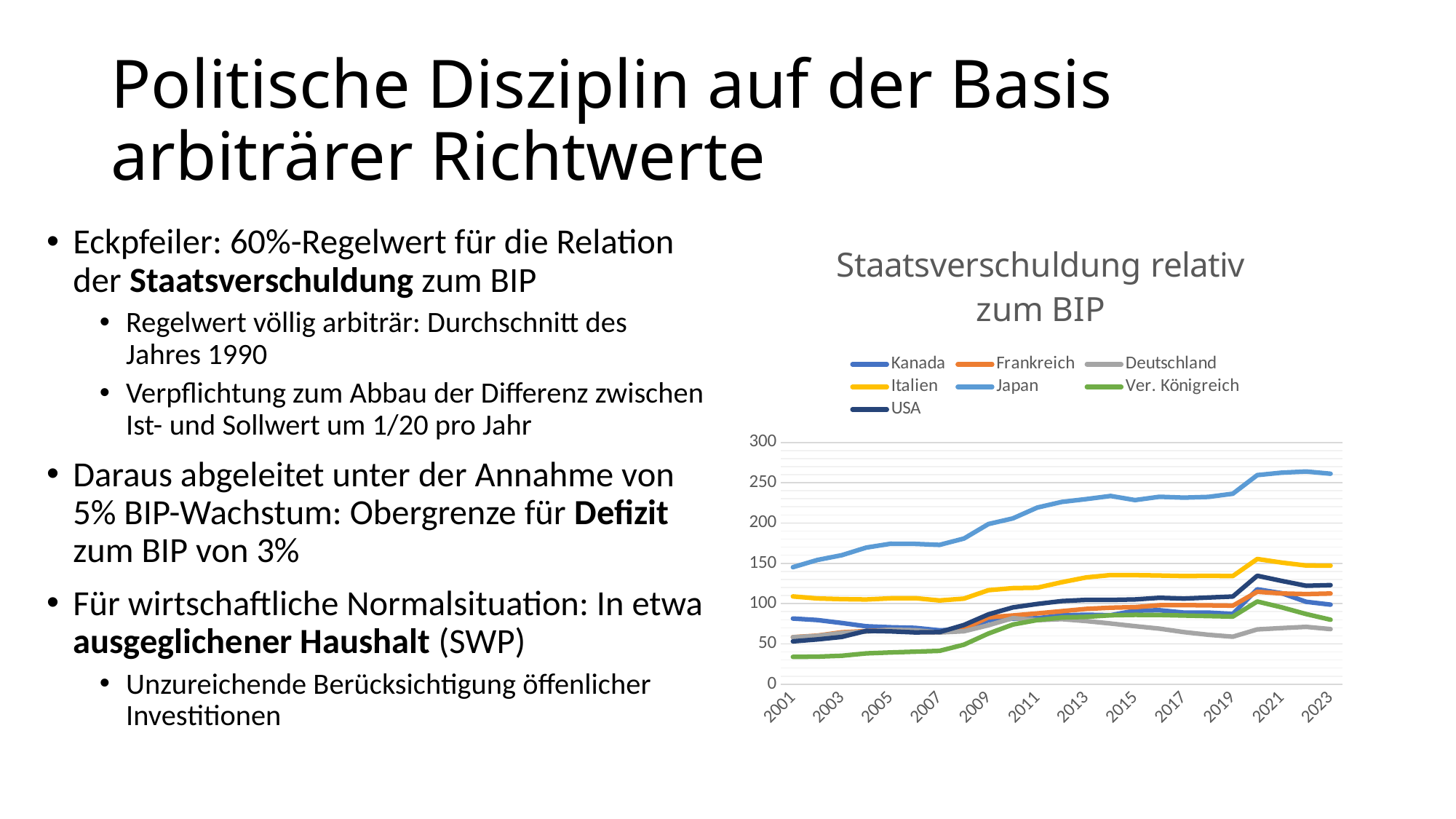
Is the value for Ver. Königreich in 2001 greater or less than 50? less What is the title of the chart? Staatsverschuldung relativ zum BIP Which series has the highest values across the whole period? Japan Is the value for Japan in 2023 greater or less than 250? greater Which is larger in 2023, the value for Italien or the value for Deutschland? Italien Does the value for Japan rise or fall from 2001 to 2023? rise How many series does the legend of the chart list? 7 Which series has the lowest value in 2001? Ver. Königreich Is the value for Japan in 2001 greater or less than 100? greater What kind of chart is shown on the slide? line chart How many year labels are shown on the x axis of the chart? 12